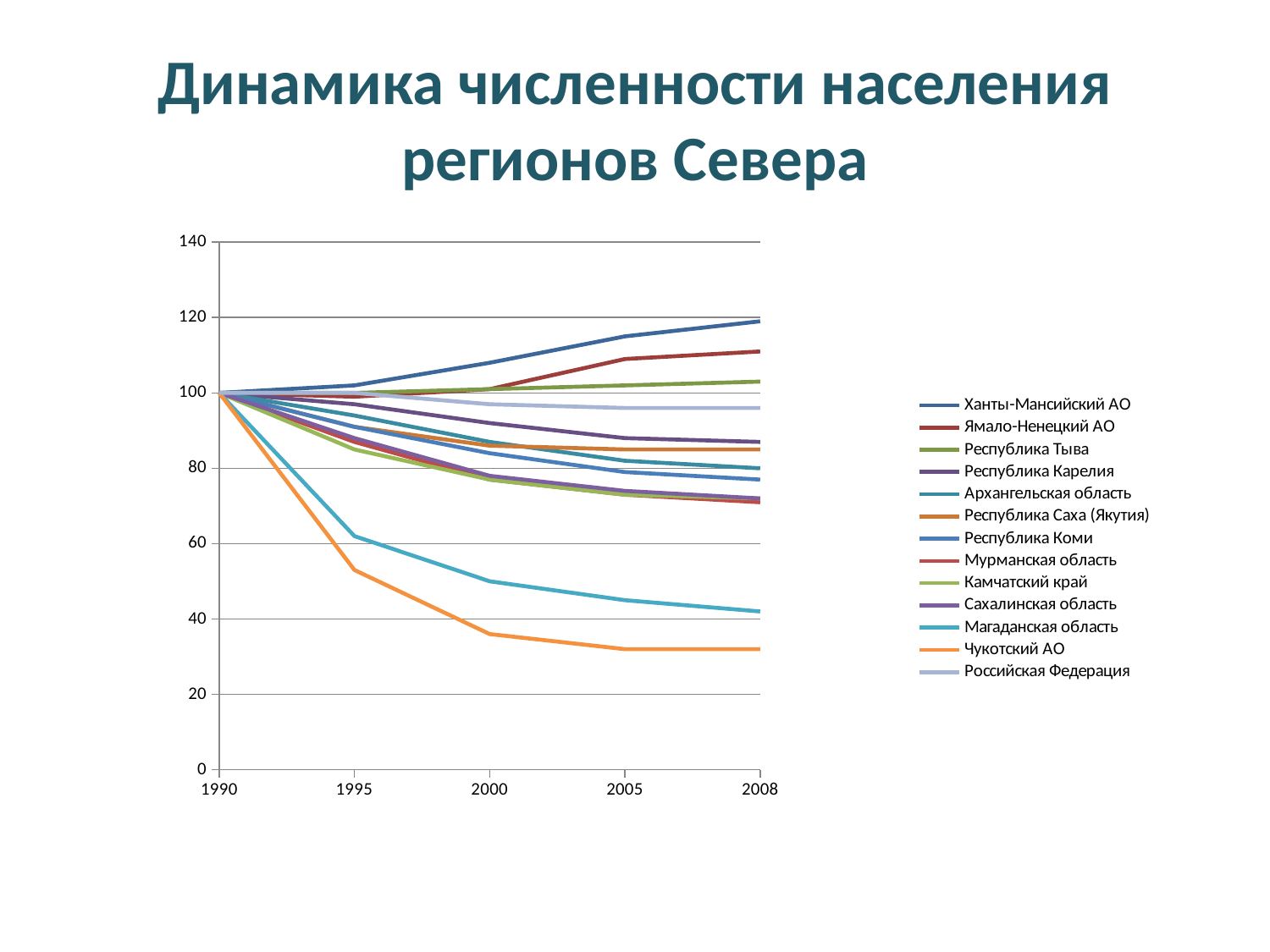
Which region has the highest value in 2008? Ханты-Мансийский АО Is the value for Чукотский АО in 2008 greater or less than 40? less Is the value for Ханты-Мансийский АО in 2008 greater or less than 100? greater Does the line for Чукотский АО rise or fall from 1990 to 2008? fall How many series does the legend list? 13 Does the line for Ханты-Мансийский АО rise or fall from 1990 to 2008? rise What kind of chart is shown on the slide? line chart What is the title of the slide? Динамика численности населения регионов Севера Which is larger in 2008, the value for Ямало-Ненецкий АО or the value for Республика Тыва? Ямало-Ненецкий АО Which region has the lowest value in 2008? Чукотский АО How many years are marked on the x axis? 5 What is the value for Ханты-Мансийский АО in 1990? 100